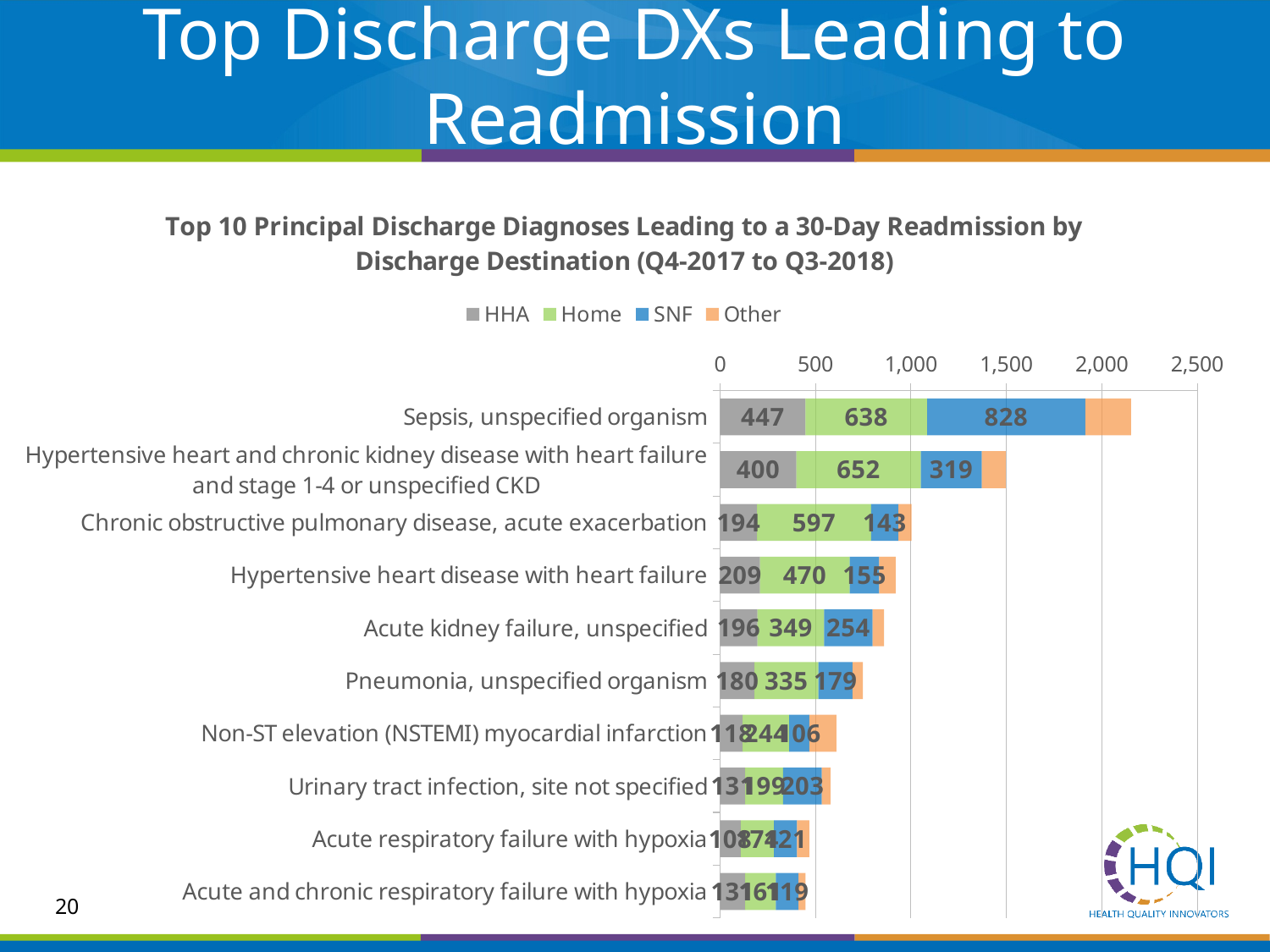
How many discharge diagnoses (categories) are plotted on the chart? 10 What is the HHA value for Sepsis, unspecified organism? 447 Which is larger for Pneumonia, unspecified organism: the HHA value or the SNF value? HHA (180) What is the SNF value for Sepsis, unspecified organism? 828 Is the total bar for Sepsis, unspecified organism greater or less than 2,000? greater What kind of chart is shown on the slide? Stacked bar chart What is the SNF value for Acute kidney failure, unspecified? 254 How many series does the legend list? 4 What is the Home value for Hypertensive heart and chronic kidney disease with heart failure and stage 1-4 or unspecified CKD? 652 Which discharge diagnosis has the longest total bar? Sepsis, unspecified organism What is the Home value for Chronic obstructive pulmonary disease, acute exacerbation? 597 What is the difference between the SNF value and the HHA value for Sepsis, unspecified organism? 381